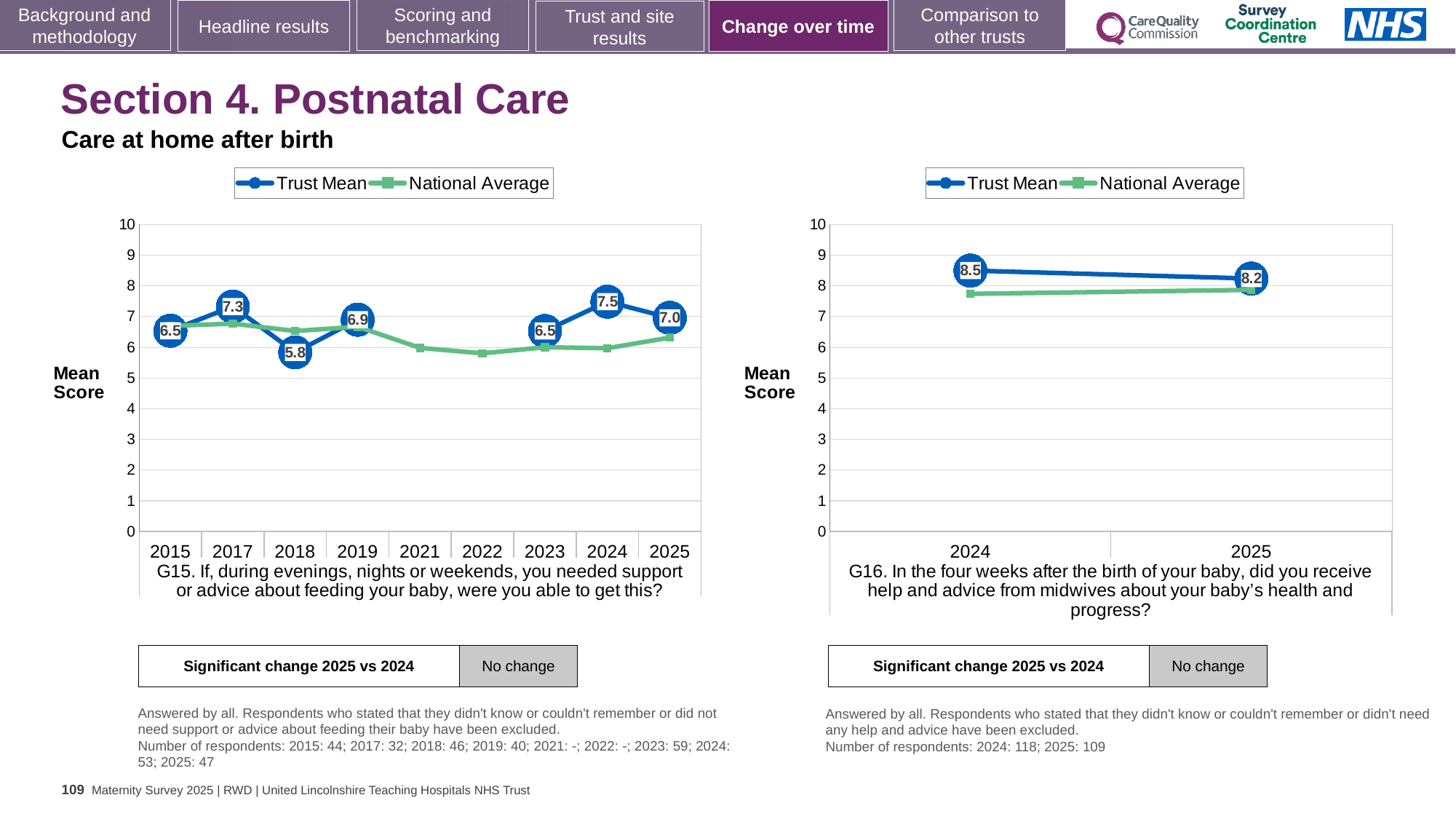
In the G15 chart on the left, what is the Trust Mean for 2018? 5.8 In the G15 chart on the left, what is the difference between the Trust Mean for 2024 and 2025? 0.5 How many years are shown on the x axis of the G15 chart on the left? 9 In the G16 chart on the right, is the National Average for 2024 greater or less than 8? less What kind of chart is the G16 chart on the right? Line chart In the G15 chart on the left, what is the Trust Mean for 2024? 7.5 In the G15 chart on the left, which year has the lowest labelled Trust Mean? 2018 In the G16 chart on the right, what is the difference between the Trust Mean for 2024 and 2025? 0.3 How many series does the legend of the G16 chart on the right list? 2 In the G16 chart on the right, what is the Trust Mean for 2025? 8.2 In the G15 chart on the left, which is larger: the Trust Mean for 2017 or for 2019? 2017 In the G15 chart on the left, which year has the highest labelled Trust Mean? 2024